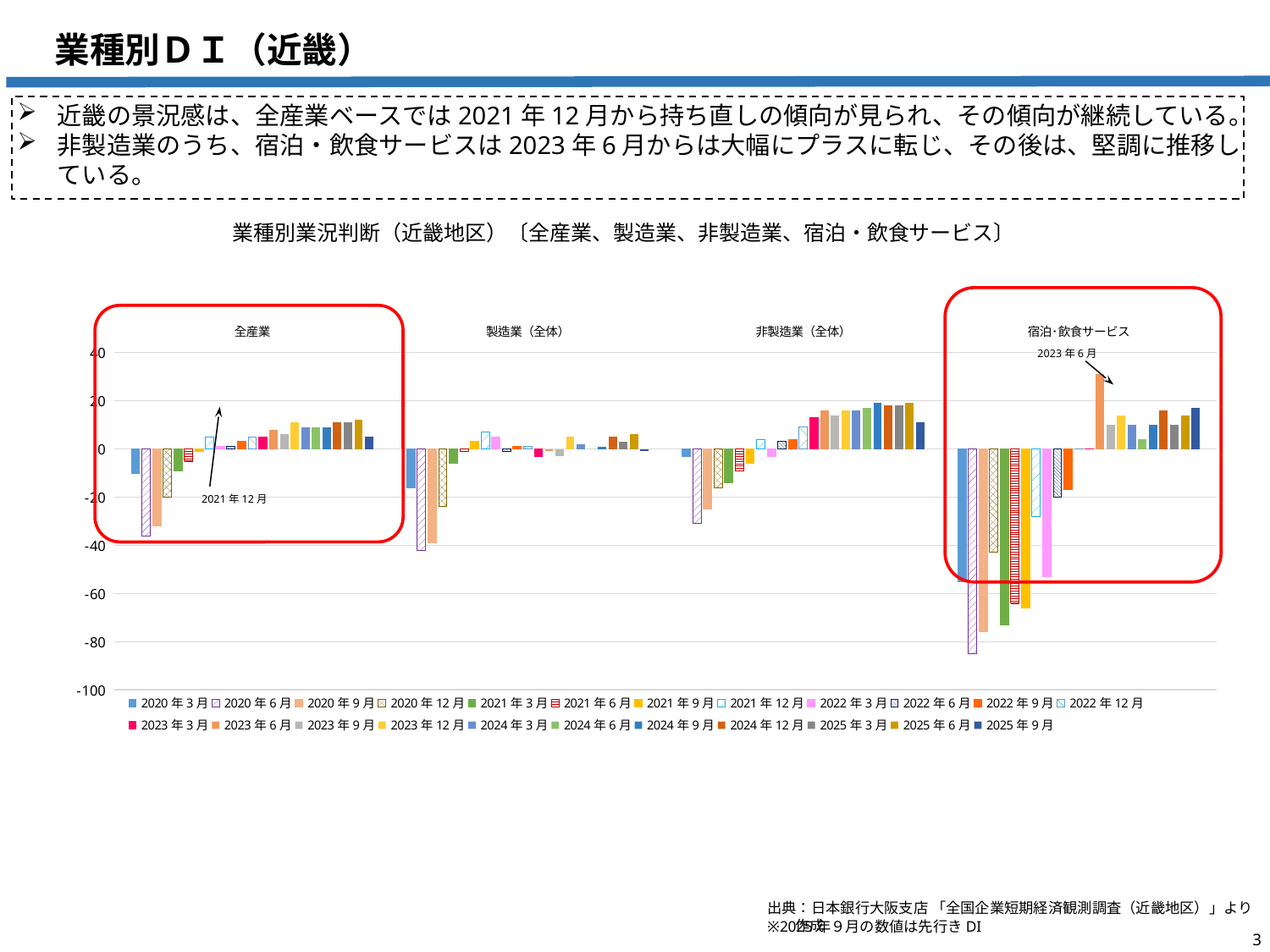
In the 全産業 group, do the values rise or fall from 2020年9月 to 2021年12月? rise How many series does the chart's legend list? 23 What kind of chart is shown on the slide? bar chart Which industry group contains the lowest bar in the chart? 宿泊・飲食サービス For 2020年6月, which group has the lower value: 製造業（全体） or 非製造業（全体）? 製造業（全体） How many industry groups are plotted along the x axis of the chart? 4 What is the lowest tick value shown on the chart's vertical axis? -100 Is the value for 2022年3月 in the 宿泊・飲食サービス group greater or less than -40? less Is the value for 2020年6月 in the 宿泊・飲食サービス group greater or less than -80? less Is the value for 2020年9月 in the 全産業 group greater or less than -20? less